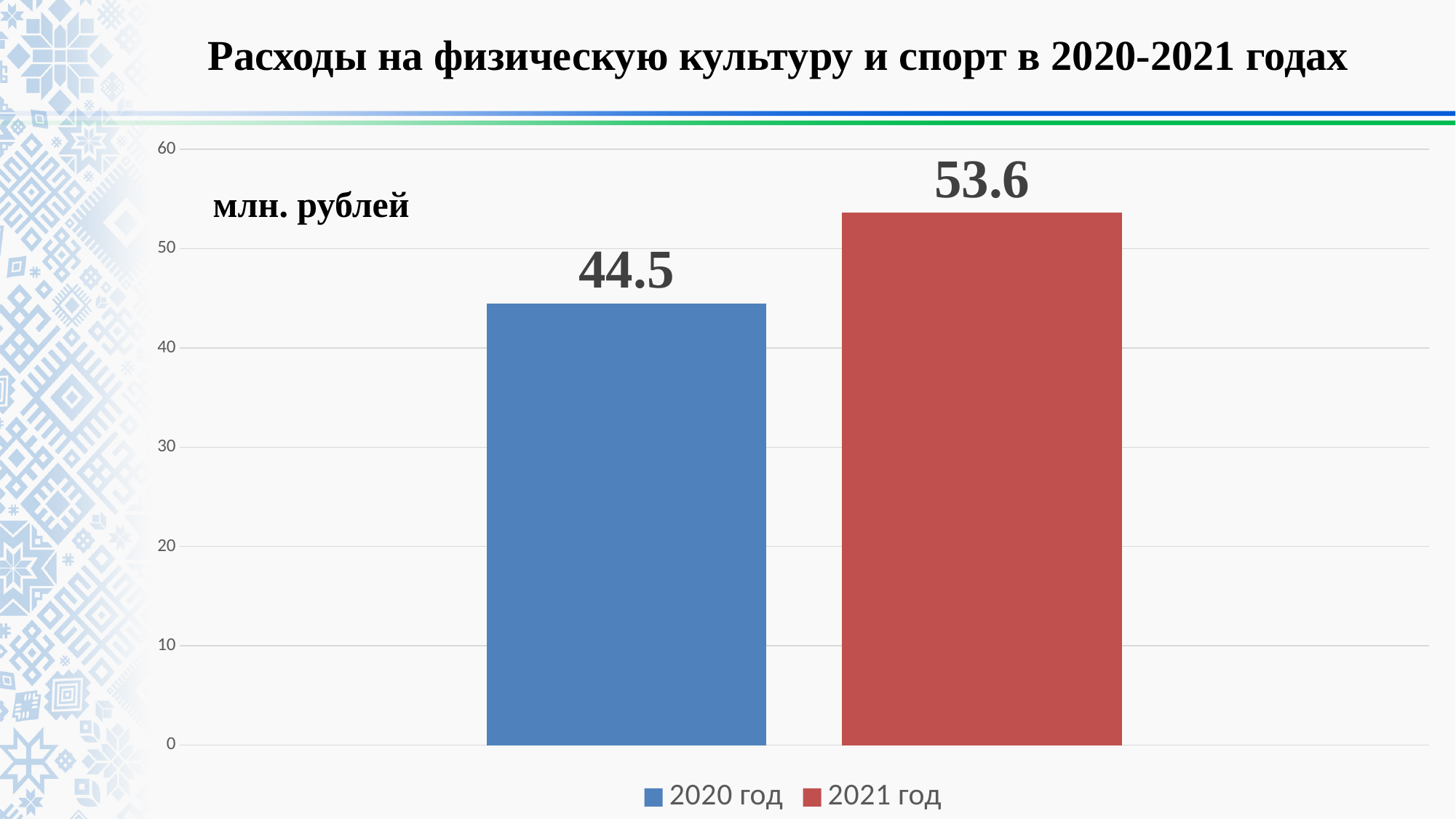
Is the value for 2020 год larger or smaller than the value for 2021 год? smaller What is the difference between the values for 2021 год and 2020 год? 9.1 Is the value for 2020 год greater or less than 40? greater What unit of measurement is indicated on the chart? млн. рублей Which year has the lower expenditure? 2020 год What is the value for 2020 год? 44.5 What is the value for 2021 год? 53.6 How many series does the legend list? 2 Which year has the higher expenditure? 2021 год How many bars are plotted on the chart? 2 Is the value for 2021 год greater or less than 50? greater What kind of chart is shown on the slide? bar chart